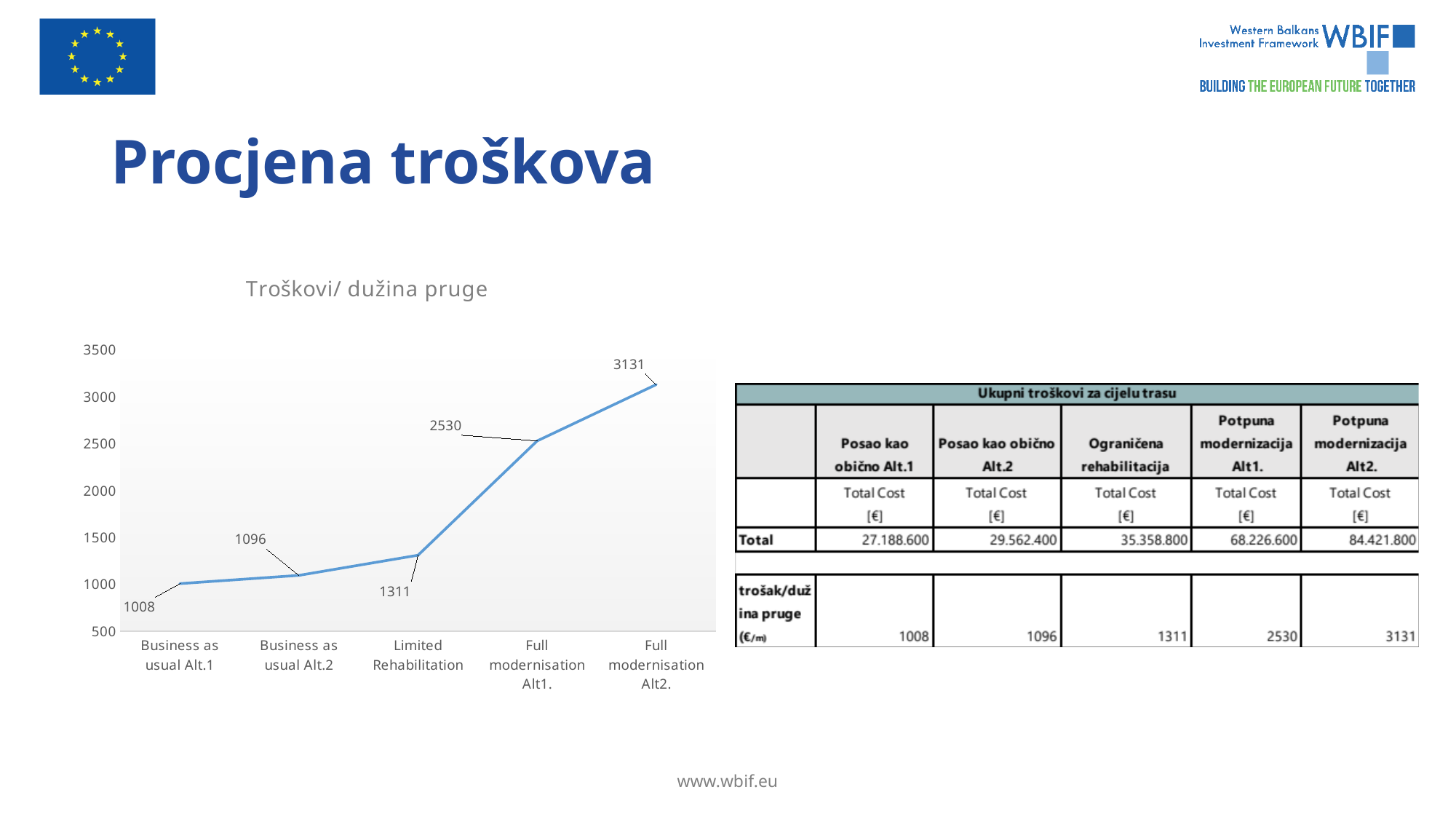
What is the difference between the values for Full modernisation Alt2. and Full modernisation Alt1.? 601 Which category has the lowest value in the chart? Business as usual Alt.1 Is the value for Full modernisation Alt1. greater or less than 2000? greater What is the value for Business as usual Alt.1 in the chart? 1008 What is the value for Limited Rehabilitation in the chart? 1311 Do the values rise or fall from left to right along the x axis? rise Which category has the highest value in the chart? Full modernisation Alt2. How many categories are plotted on the x axis of the chart? 5 Which is larger, the value for Limited Rehabilitation or the value for Business as usual Alt.2? Limited Rehabilitation What is the difference between the values for Business as usual Alt.2 and Business as usual Alt.1? 88 What kind of chart is shown on the slide? line chart What is the value for Full modernisation Alt2. in the chart? 3131